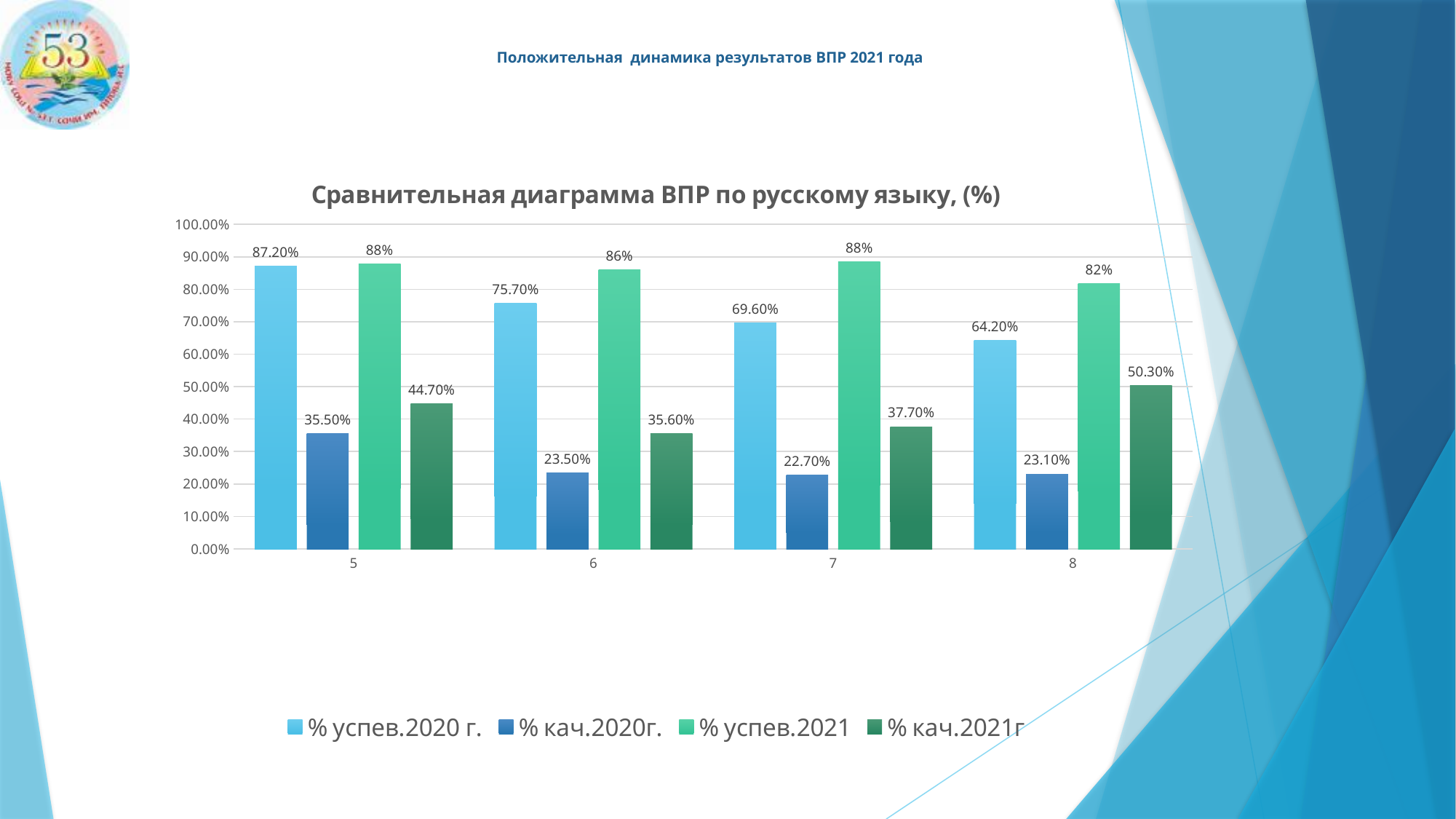
Does the value of % успев.2020 г. rise or fall from category 5 to category 8? Fall Which category has the lowest value for % успев.2020 г.? 8 What type of chart is shown on the slide? Bar chart What is the value of % кач.2020г. for category 7? 22.70% How many series does the legend list? 4 What is the value of % кач.2021г for category 8? 50.30% Which category has the highest value for % кач.2021г? 8 How many categories are shown on the x axis? 4 Which is larger for category 5: % кач.2020г. or % кач.2021г? % кач.2021г What is the difference between % успев.2021 and % успев.2020 г. for category 6? 10.30% What is the value of % успев.2020 г. for category 5? 87.20% What is the value of % успев.2021 for category 6? 86%